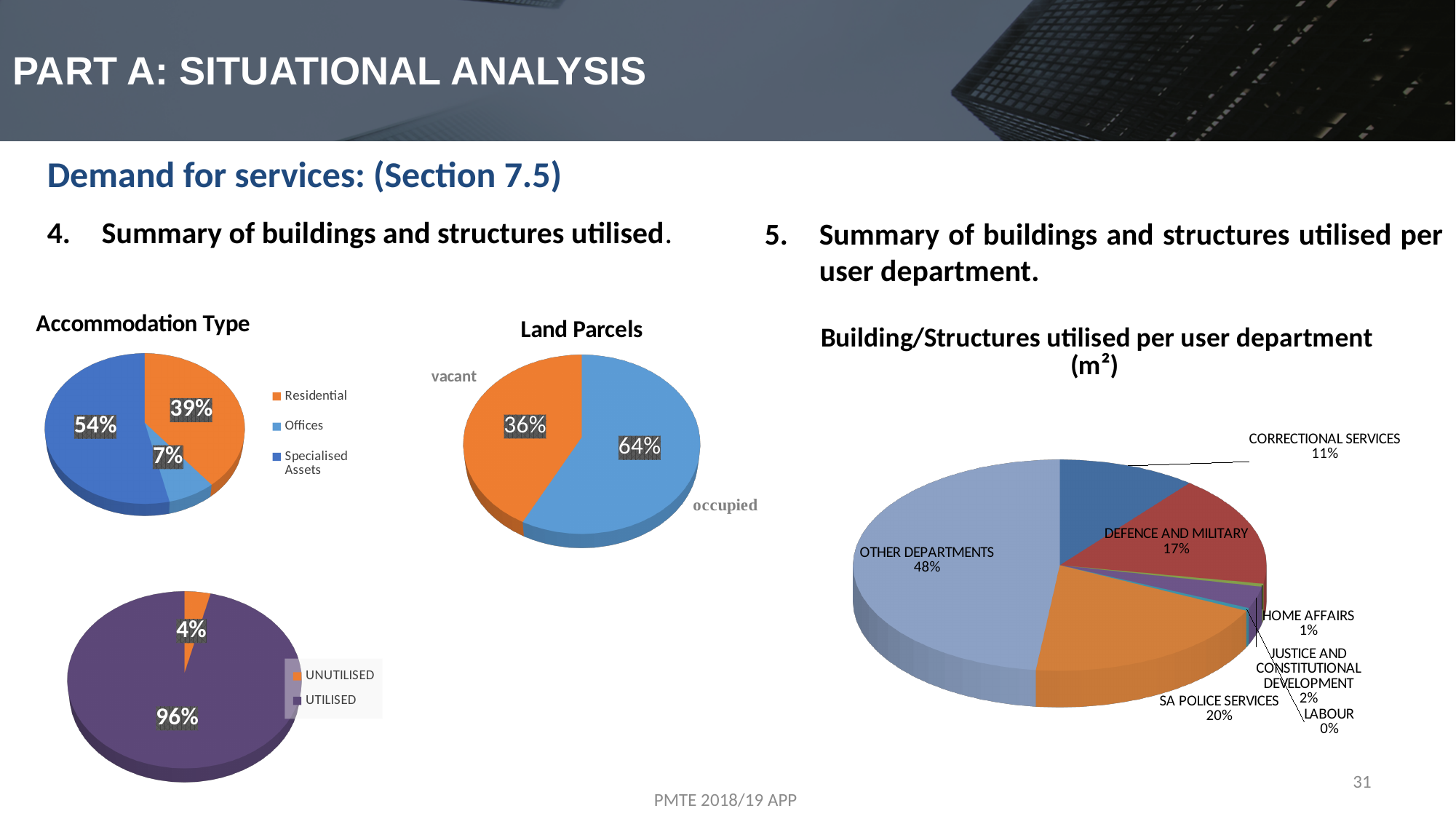
In the Building/Structures utilised per user department (m²) chart, which department has the largest share? OTHER DEPARTMENTS In the Land Parcels chart, what is the difference between the occupied and vacant shares? 28% In the Accommodation Type chart, which category has the largest share? Specialised Assets How many categories does the Accommodation Type chart show? 3 In the Accommodation Type chart, what share is Offices? 7% In the Building/Structures utilised per user department (m²) chart, what share is SA POLICE SERVICES? 20% How many departments are labelled in the Building/Structures utilised per user department (m²) chart? 7 What kind of chart is the Land Parcels chart? Pie chart In the bottom-left pie chart with the UNUTILISED and UTILISED legend, what share is UNUTILISED? 4% In the Building/Structures utilised per user department (m²) chart, which is larger, DEFENCE AND MILITARY or CORRECTIONAL SERVICES? DEFENCE AND MILITARY